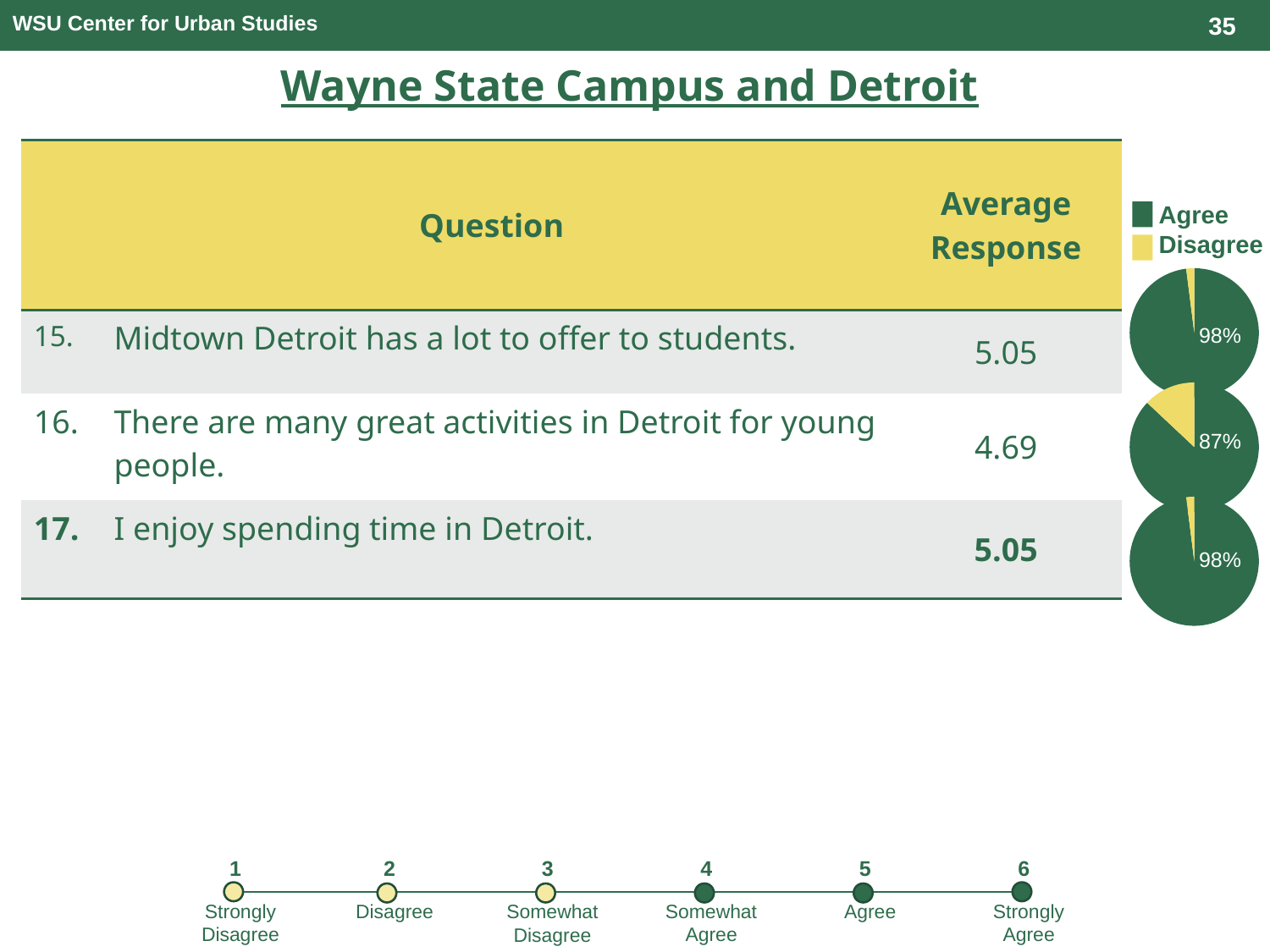
In the middle pie chart (question 16), is the Agree slice larger or smaller than the Disagree slice? Larger How many categories does the pie chart legend list? 2 What is the difference between the Agree percentage for question 15 and the Agree percentage for question 16? 11% How many pie charts are shown on the slide? 3 Is the Agree percentage larger in the pie chart for question 16 or the pie chart for question 17? Question 17 In the pie chart next to question 15 (top pie), what percentage of respondents agree? 98% Which question's pie chart shows the lowest Agree percentage? Question 16 In the pie charts, which colour represents Agree? Dark green In the pie chart next to question 17 (bottom pie), what percentage of respondents agree? 98% In the pie charts, which colour represents Disagree? Yellow In the pie chart next to question 16 (middle pie), what percentage of respondents agree? 87% What type of chart is used to show the Agree/Disagree split for each question? Pie chart